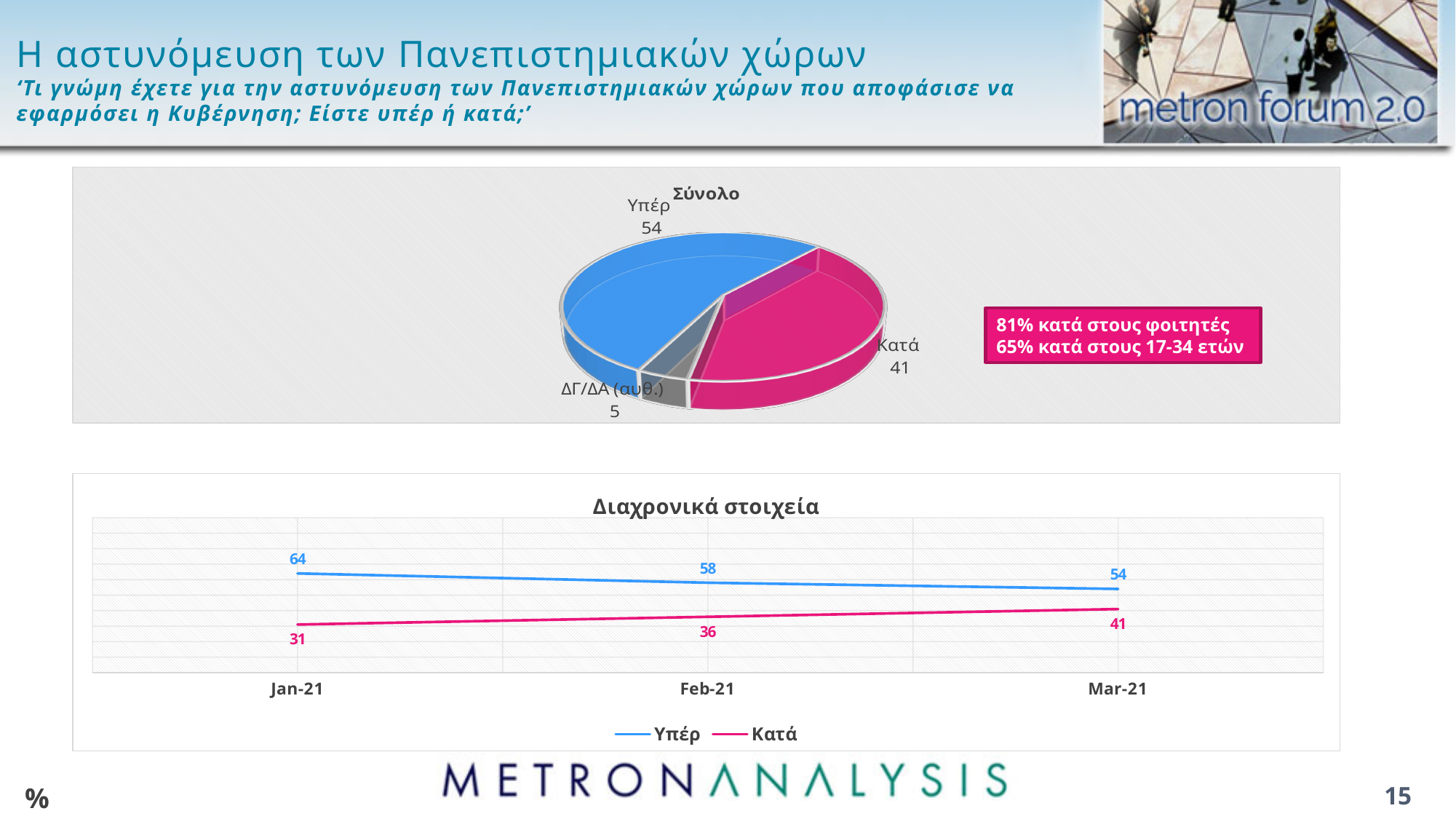
In the chart titled Διαχρονικά στοιχεία, does the Υπέρ series rise or fall from Jan-21 to Mar-21? fall In the pie chart titled Σύνολο, what is the value for Κατά? 41 In the pie chart titled Σύνολο, what is the difference between Υπέρ and Κατά? 13 In the chart titled Διαχρονικά στοιχεία, what is the value for Κατά in Feb-21? 36 In the pie chart titled Σύνολο, how many slices are there? 3 In the chart titled Διαχρονικά στοιχεία, what is the difference between the Κατά values in Mar-21 and Jan-21? 10 In the pie chart titled Σύνολο, which category has the smallest slice? ΔΓ/ΔΑ (αυθ.) In the chart titled Διαχρονικά στοιχεία, how many series does the legend list? 2 In the pie chart titled Σύνολο, what is the value for Υπέρ? 54 What kind of chart is the chart titled Διαχρονικά στοιχεία? line chart In the chart titled Διαχρονικά στοιχεία, what is the value for Υπέρ in Jan-21? 64 In the chart titled Διαχρονικά στοιχεία, which is larger in Mar-21, Υπέρ or Κατά? Υπέρ